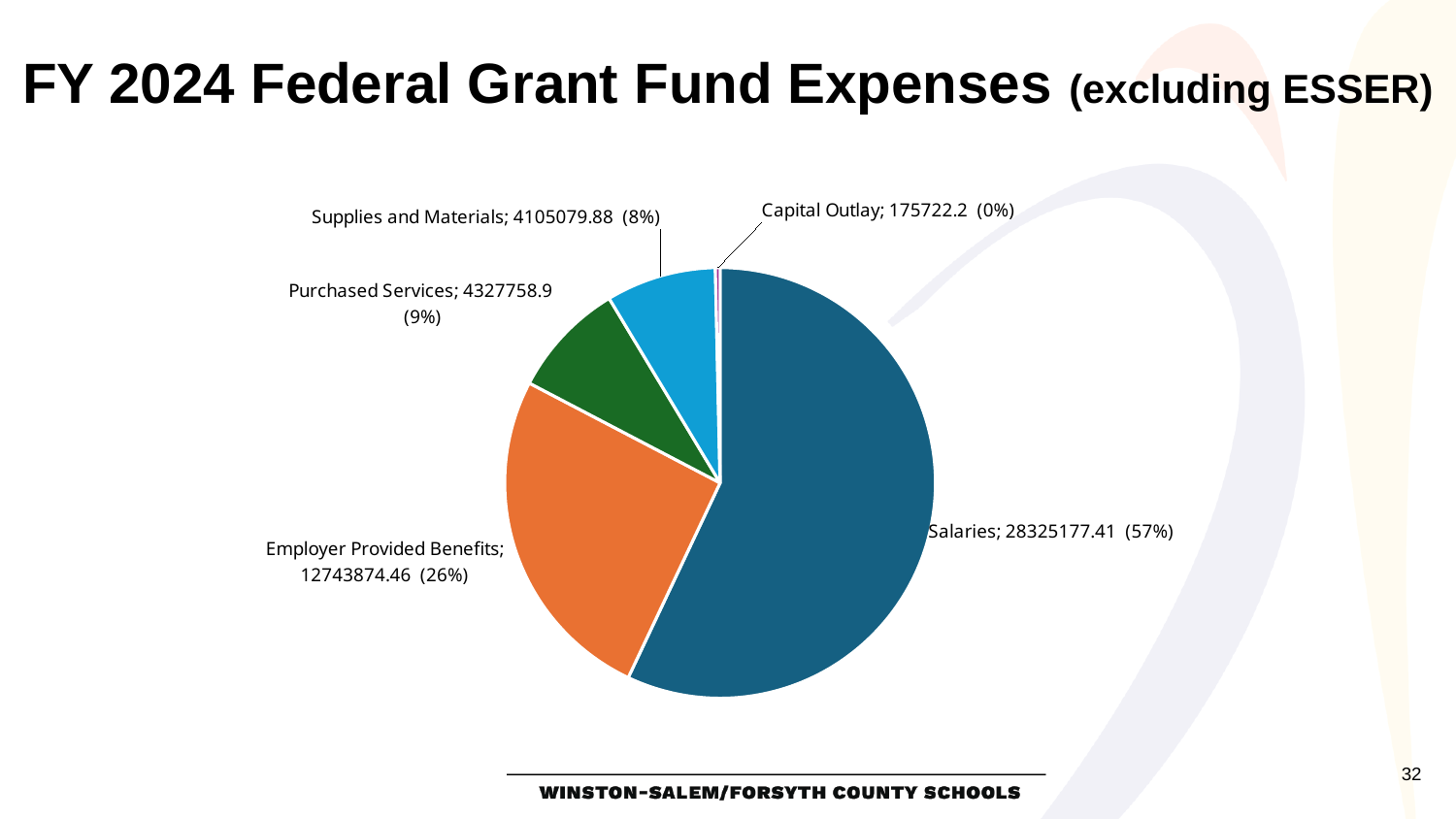
What is the value for Capital Outlay? 175722.2 What is the value for Employer Provided Benefits? 12743874.46 What kind of chart is shown on the slide? Pie chart What is the value for Salaries? 28325177.41 Which is larger, the value for Purchased Services or the value for Supplies and Materials? Purchased Services How many categories are shown in the pie chart? 5 What is the title of the slide containing the chart? FY 2024 Federal Grant Fund Expenses (excluding ESSER) What percentage share does Purchased Services have? 9% Which category has the largest share of the pie? Salaries What percentage share does Employer Provided Benefits have? 26% Which category has the smallest share of the pie? Capital Outlay What is the difference between the values for Salaries and Employer Provided Benefits? 15581302.95